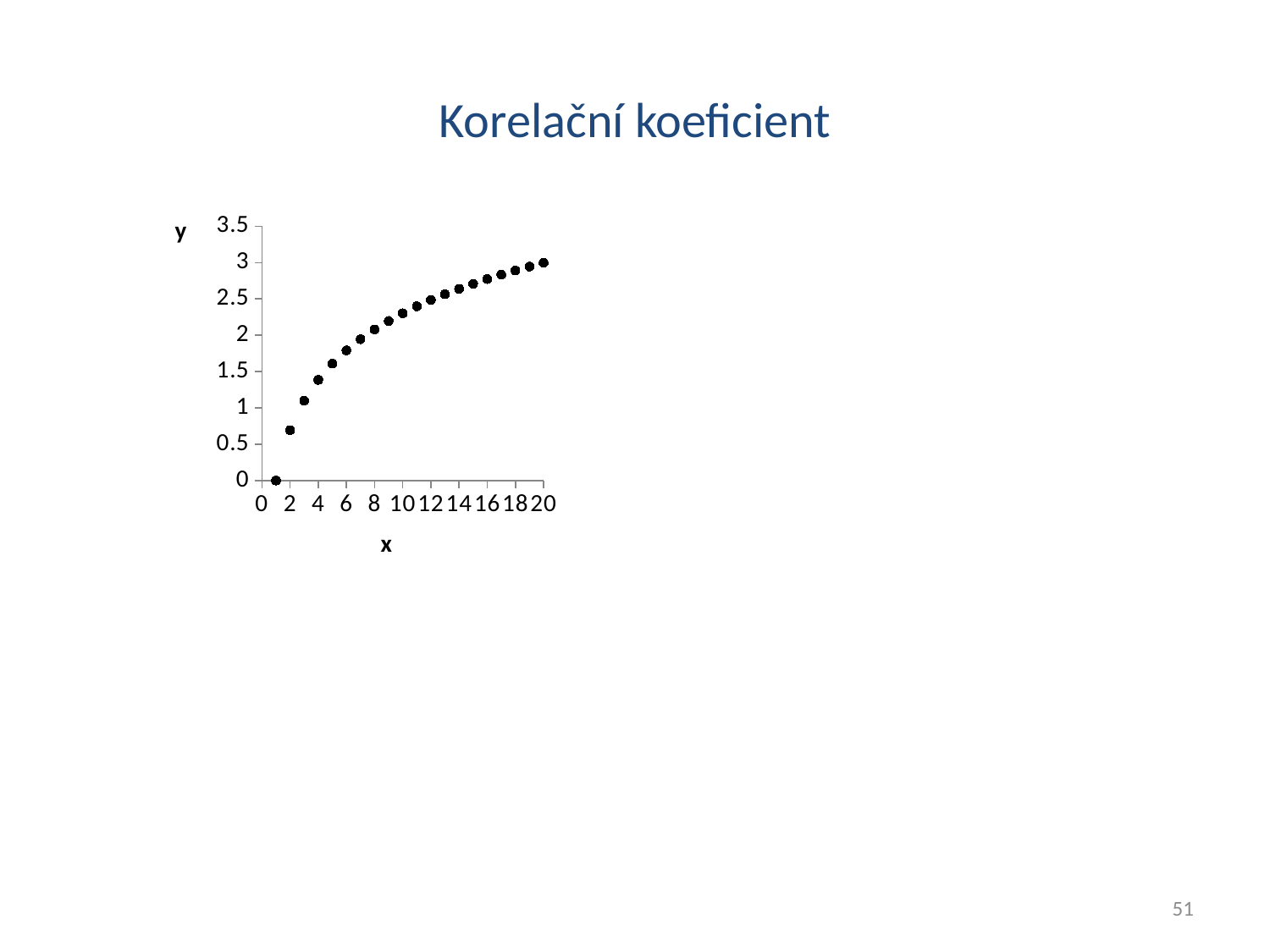
What is the y value of the point at x = 1? 0 At which x value is the y value highest? 20 How many data points are plotted on the chart? 20 Do the y values rise or fall as x increases along the x axis? rise Is the y value at x = 20 greater or less than 2.5? greater Is the y value at x = 2 greater or less than 1? less What are the labels of the horizontal and vertical axes of the chart? x and y What is the title of the slide containing the chart? Korelační koeficient What kind of chart is shown on the slide? scatter plot At which x value is the y value lowest? 1 Is the y value at x = 10 greater or less than 2? greater Which point has a larger y value, the one at x = 4 or the one at x = 16? x = 16